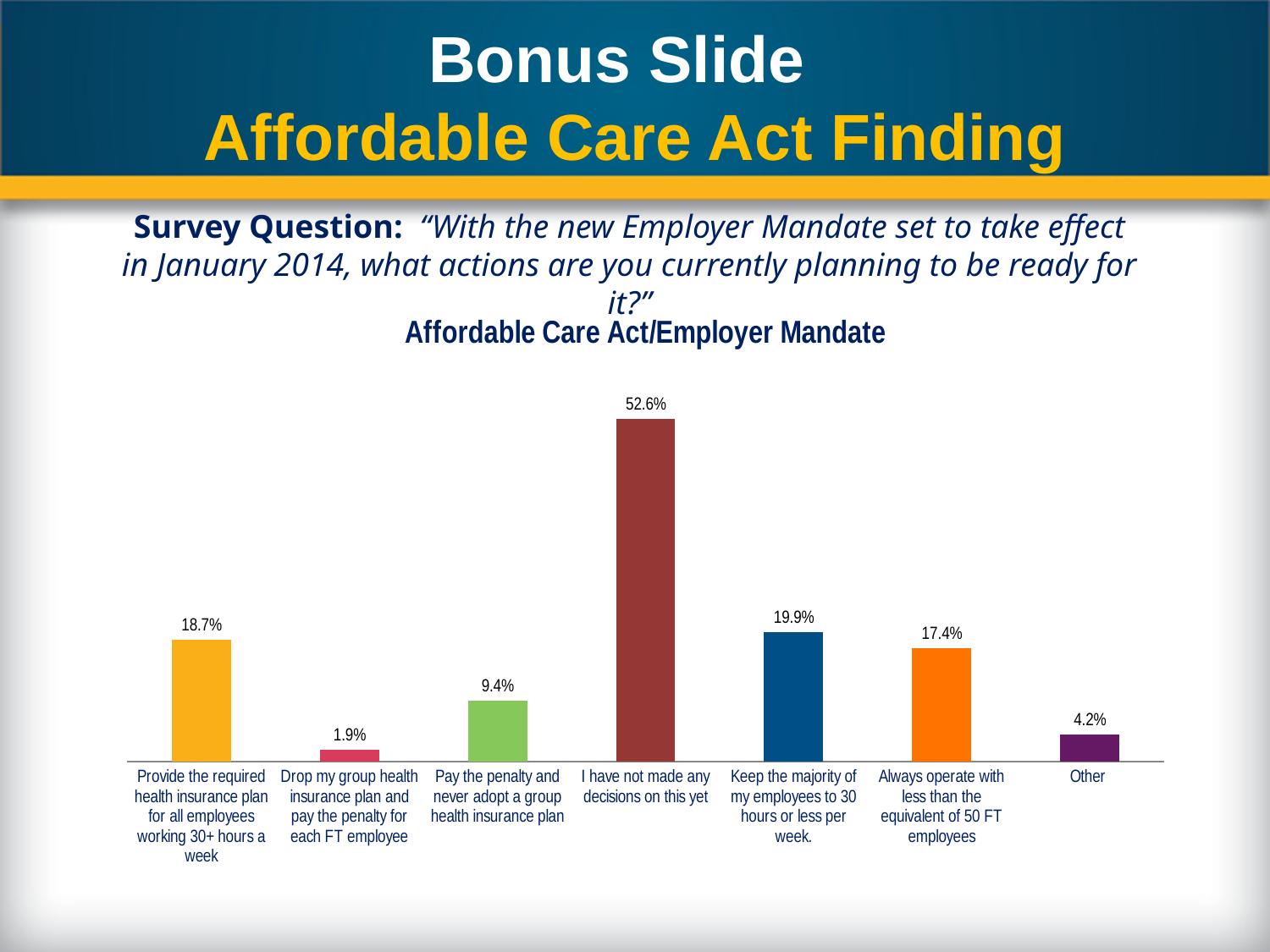
What is the value for 'Other'? 4.2% What is the value for 'Keep the majority of my employees to 30 hours or less per week'? 19.9% Which category has the highest value? I have not made any decisions on this yet What is the difference between 'I have not made any decisions on this yet' and 'Keep the majority of my employees to 30 hours or less per week'? 32.7% Which category has the lowest value? Drop my group health insurance plan and pay the penalty for each FT employee What is the value for 'Provide the required health insurance plan for all employees working 30+ hours a week'? 18.7% What is the title of the chart? Affordable Care Act/Employer Mandate What percentage of respondents said they have not made any decisions on this yet? 52.6% What is the difference between 'Pay the penalty and never adopt a group health insurance plan' and 'Other'? 5.2% Which is larger: 'Always operate with less than the equivalent of 50 FT employees' or 'Provide the required health insurance plan for all employees working 30+ hours a week'? Provide the required health insurance plan for all employees working 30+ hours a week How many categories are shown in the chart? 7 What type of chart is shown on the slide? Bar chart